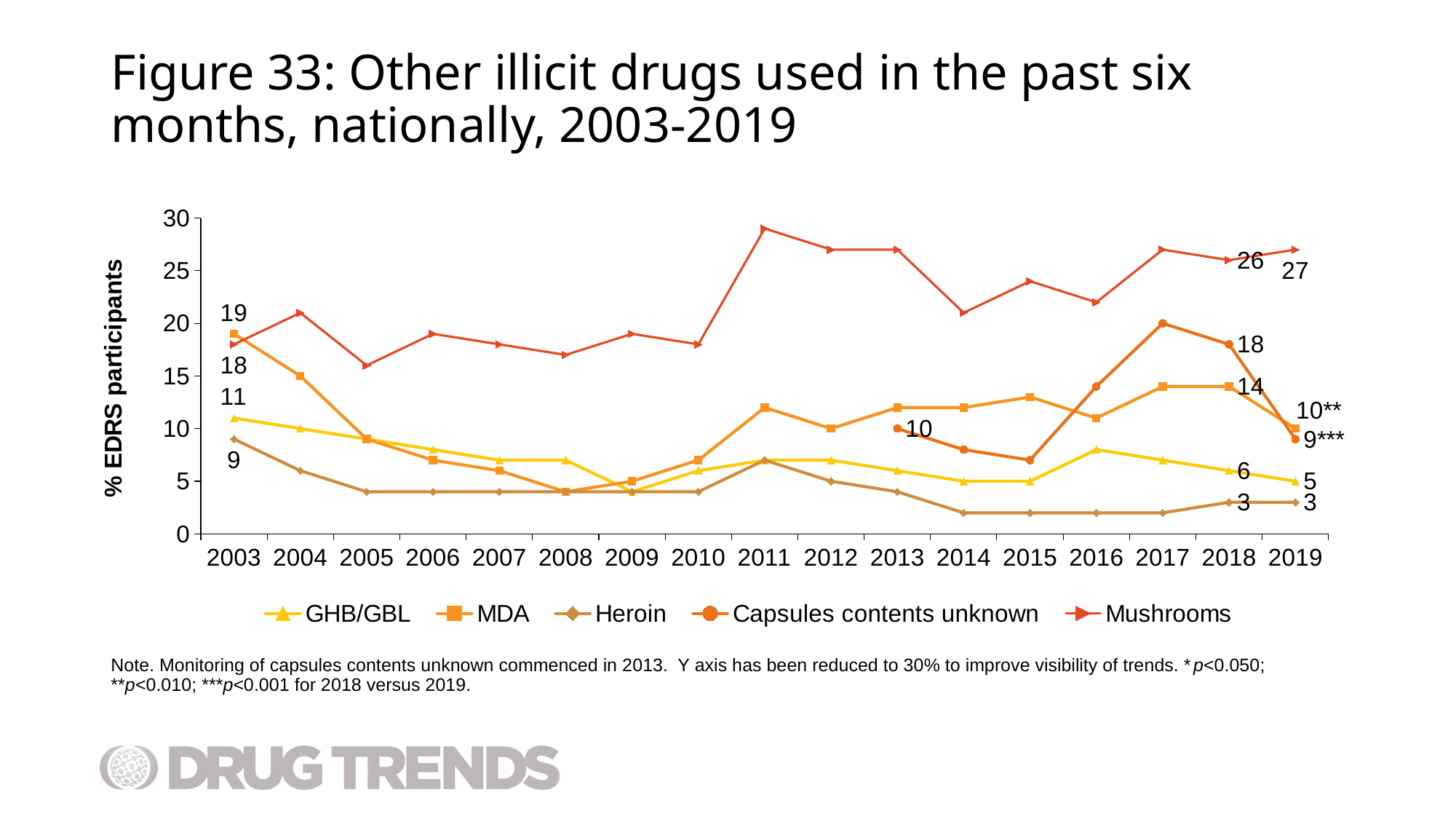
What is the value for Capsules contents unknown in 2013? 10 What is the difference between the Mushrooms values in 2019 and 2018? 1 In 2018, which is larger: MDA or Capsules contents unknown? Capsules contents unknown By how much did the value for Capsules contents unknown fall from 2018 to 2019? 9 What is the value for MDA in 2003? 19 How many years are shown along the x axis? 17 What kind of chart is shown on the slide? line chart How many series does the legend list? 5 Is the value for Mushrooms in 2011 greater or less than 25? greater What is the value for Heroin in 2018? 3 What is the value for Mushrooms in 2019? 27 Which series has the highest value in 2019? Mushrooms